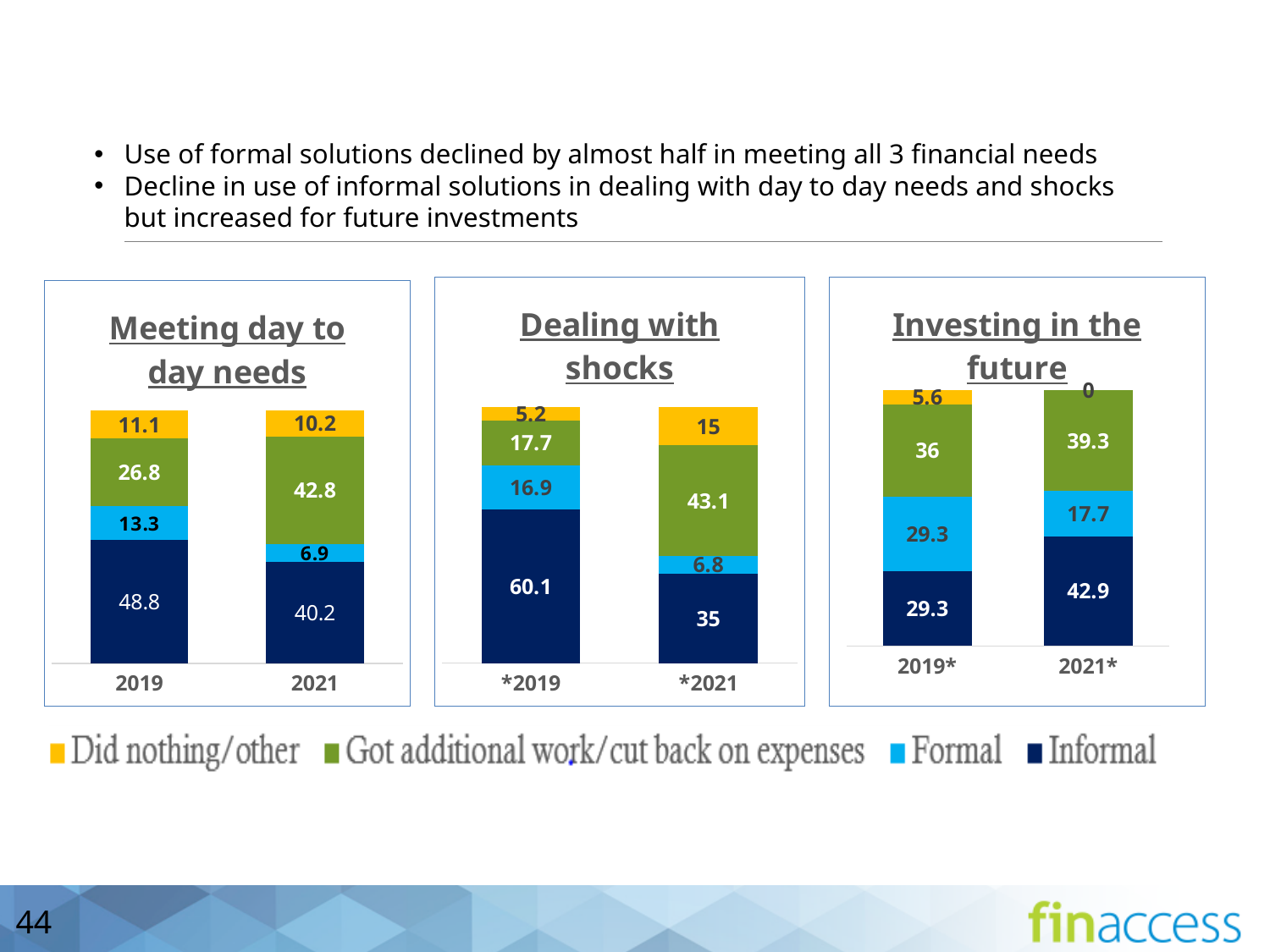
In the 'Meeting day to day needs' chart, which year has the larger 'Got additional work/cut back on expenses' value, 2019 or 2021? 2021 In the 'Investing in the future' chart, what is the difference between the Formal values for 2019* and 2021*? 11.6 In the 'Dealing with shocks' chart, what is the 'Got additional work/cut back on expenses' value for *2021? 43.1 In the 'Meeting day to day needs' chart, what is the Formal value for 2021? 6.9 In the 'Dealing with shocks' chart, which segment is the largest in the *2019 bar? Informal In the 'Investing in the future' chart, what is the 'Did nothing/other' value for 2021*? 0 In the 'Investing in the future' chart, does the Informal value rise or fall from 2019* to 2021*? Rise What type of chart is used in the 'Dealing with shocks' panel? Stacked bar chart In the 'Dealing with shocks' chart, by how much did the Informal value fall from *2019 to *2021? 25.1 In the 'Investing in the future' chart, which segment is the smallest in the 2019* bar? Did nothing/other In the 'Meeting day to day needs' chart, what is the Informal value for 2019? 48.8 How many series does the legend list? 4